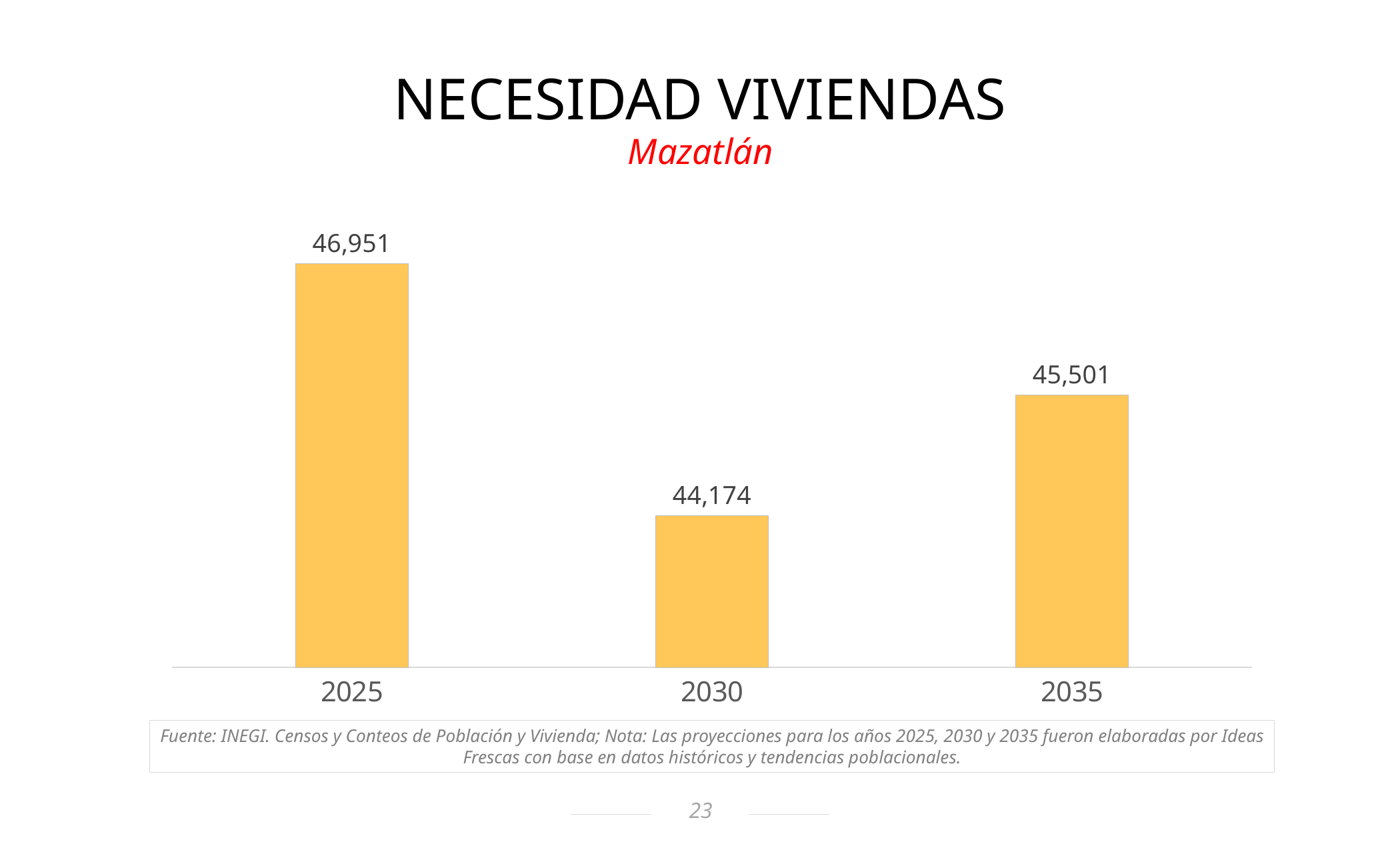
Which year has the highest value? 2025 What is the difference between the values for 2025 and 2030? 2,777 Does the value fall or rise from 2025 to 2030? fall What is the value for 2035? 45,501 What is the value for 2030? 44,174 What is the value for 2025? 46,951 How many years are shown on the chart? 3 Which year has the lowest value? 2030 What is the difference between the values for 2035 and 2030? 1,327 What is the title of the chart? NECESIDAD VIVIENDAS Mazatlán What kind of chart is shown on the slide? bar chart Which is larger, the value for 2025 or the value for 2035? 2025